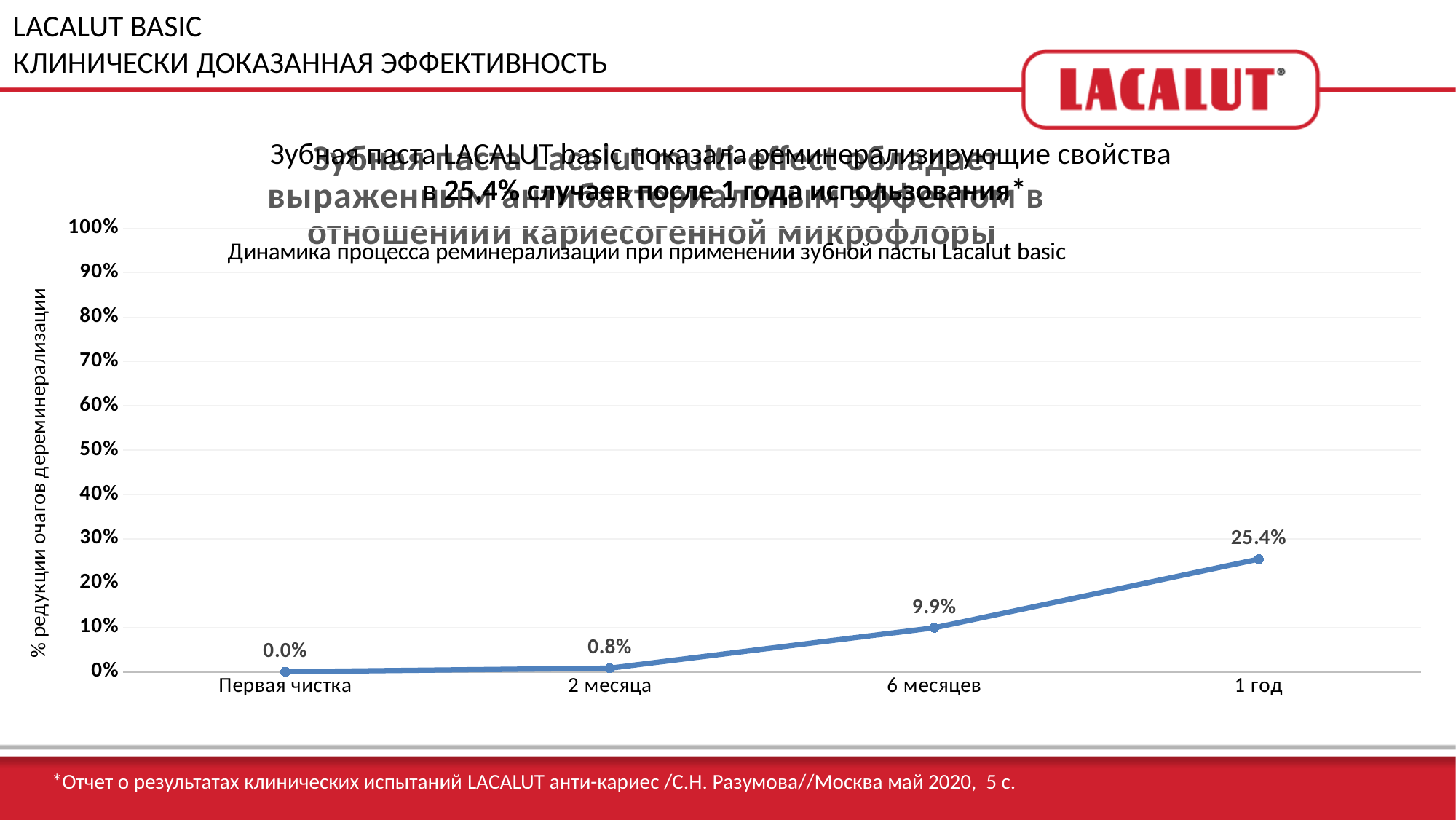
Which category has the lowest value? Первая чистка What is the value for "Первая чистка"? 0.0% Do the values rise or fall along the x axis from "Первая чистка" to "1 год"? rise What type of chart is shown on the slide? line chart What is the value for "2 месяца"? 0.8% What is the difference between the values for "1 год" and "6 месяцев"? 15.5% Which category has the highest value? 1 год Which is larger, the value for "6 месяцев" or the value for "2 месяца"? 6 месяцев How many data points are plotted on the chart? 4 What is the title of the chart? Динамика процесса реминерализации при применении зубной пасты Lacalut basic What is the value for "1 год"? 25.4% What is the value for "6 месяцев"? 9.9%